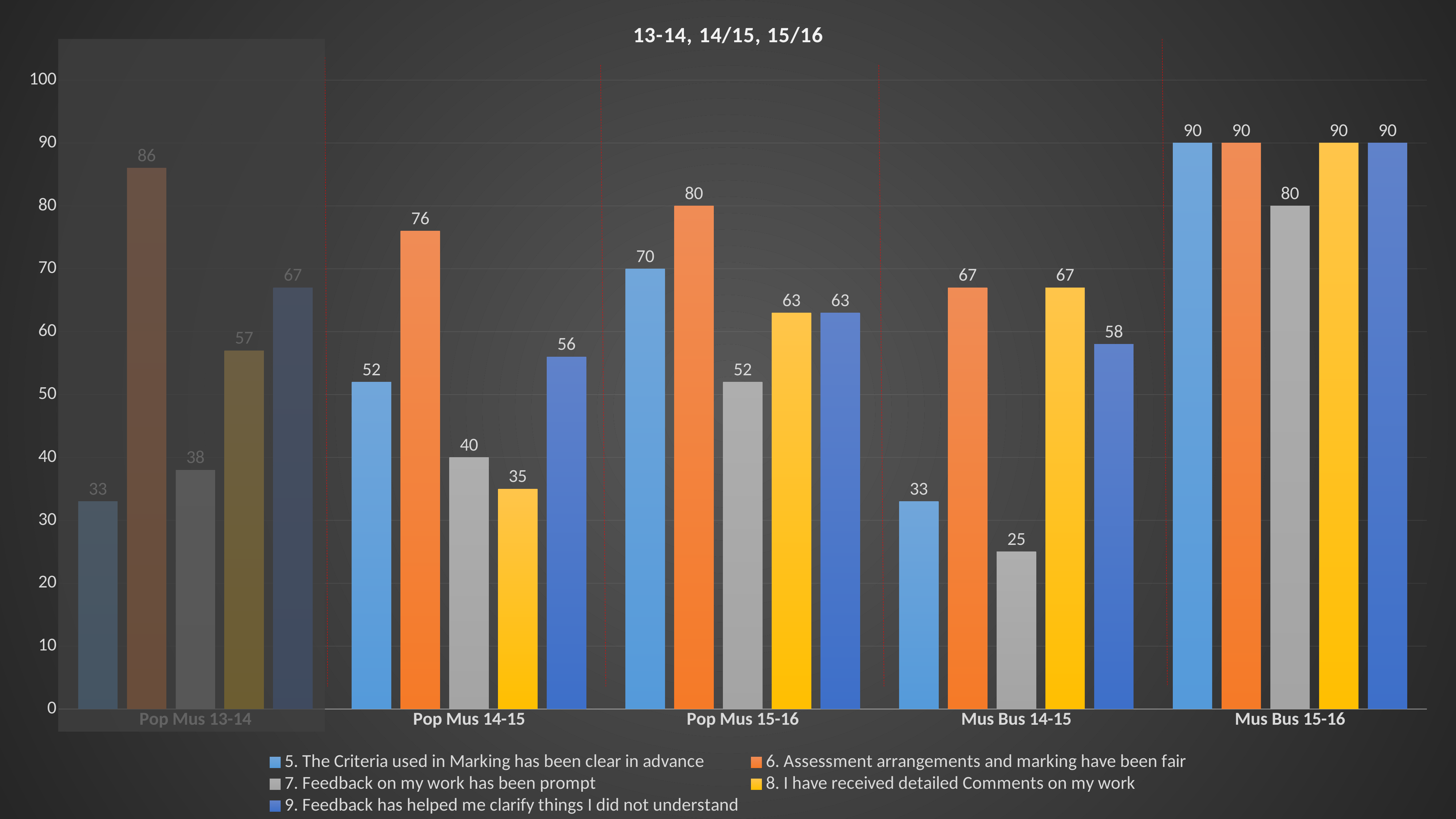
What is the difference between the values for '5. The Criteria used in Marking has been clear in advance' in Mus Bus 15-16 and Mus Bus 14-15? 57 Which is larger: the value for '9. Feedback has helped me clarify things I did not understand' in Pop Mus 13-14 or in Pop Mus 14-15? Pop Mus 13-14 Which series has the lowest value in Pop Mus 15-16? 7. Feedback on my work has been prompt What is the value for '6. Assessment arrangements and marking have been fair' in Pop Mus 13-14? 86 What type of chart is shown on the slide? bar chart How many series does the legend list? 5 How many categories are shown on the x axis? 5 Which series has the highest value in Pop Mus 14-15? 6. Assessment arrangements and marking have been fair What is the value for '7. Feedback on my work has been prompt' in Mus Bus 14-15? 25 What is the value for '8. I have received detailed Comments on my work' in Pop Mus 14-15? 35 What is the title of the chart? 13-14, 14/15, 15/16 How does the value for '5. The Criteria used in Marking has been clear in advance' change from Pop Mus 13-14 to Pop Mus 15-16? It rises